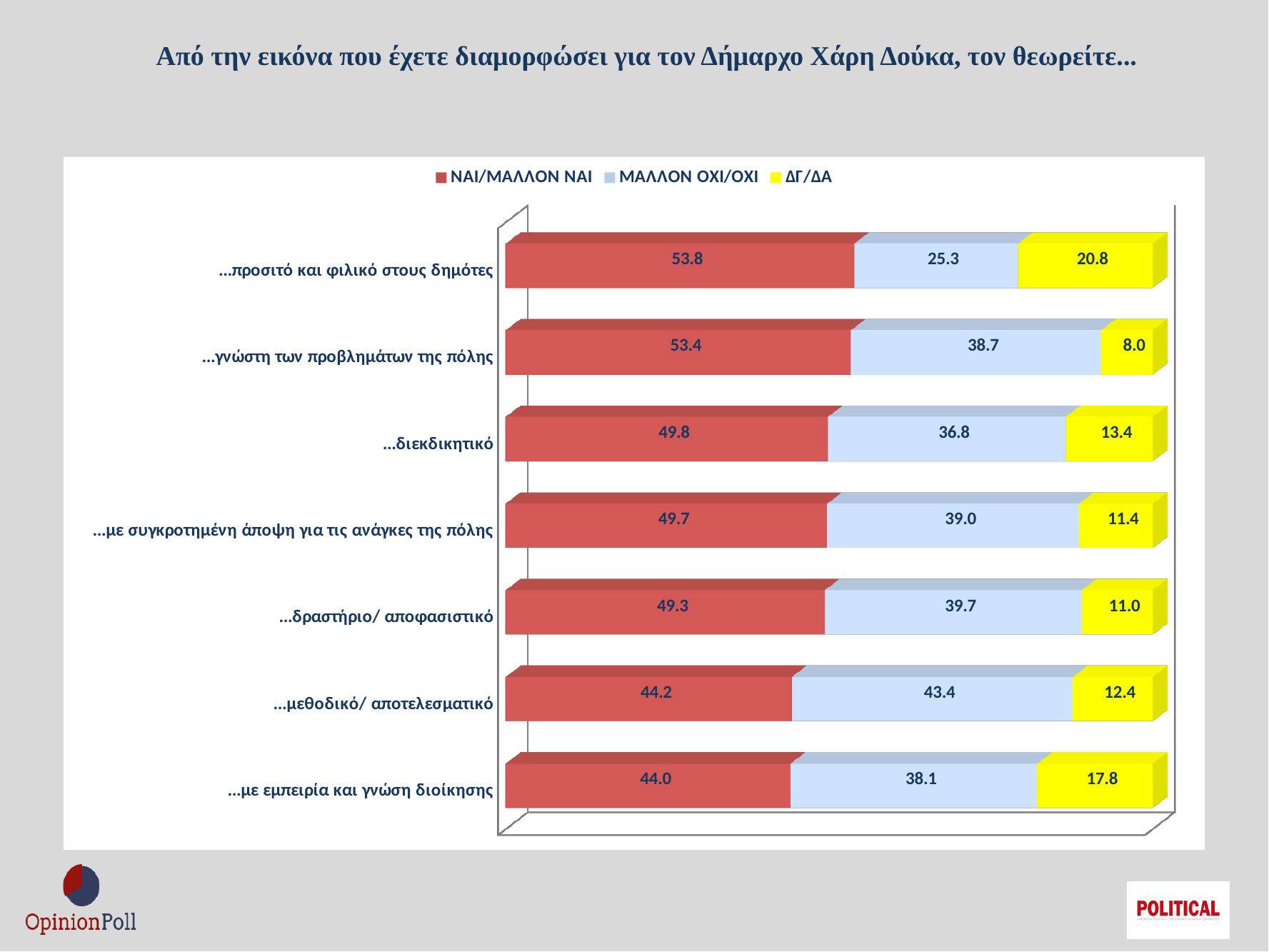
How many series does the legend list? 3 Which is larger for "...με εμπειρία και γνώση διοίκησης": the ΜΑΛΛΟΝ ΟΧΙ/ΟΧΙ value or the ΔΓ/ΔΑ value? ΜΑΛΛΟΝ ΟΧΙ/ΟΧΙ Which statement has the highest ΝΑΙ/ΜΑΛΛΟΝ ΝΑΙ value? ...προσιτό και φιλικό στους δημότες What kind of chart is shown on the slide? Stacked bar chart Which statement has the lowest ΝΑΙ/ΜΑΛΛΟΝ ΝΑΙ value? ...με εμπειρία και γνώση διοίκησης What is the total of the stacked bar for "...δραστήριο/ αποφασιστικό"? 100.0 What is the ΝΑΙ/ΜΑΛΛΟΝ ΝΑΙ value for "...διεκδικητικό"? 49.8 Which statement has the highest ΔΓ/ΔΑ value? ...προσιτό και φιλικό στους δημότες What is the difference between the ΝΑΙ/ΜΑΛΛΟΝ ΝΑΙ and ΜΑΛΛΟΝ ΟΧΙ/ΟΧΙ values for "...προσιτό και φιλικό στους δημότες"? 28.5 What is the ΜΑΛΛΟΝ ΟΧΙ/ΟΧΙ value for "...μεθοδικό/ αποτελεσματικό"? 43.4 How many categories (statements) are plotted in the chart? 7 What is the ΔΓ/ΔΑ value for "...γνώστη των προβλημάτων της πόλης"? 8.0